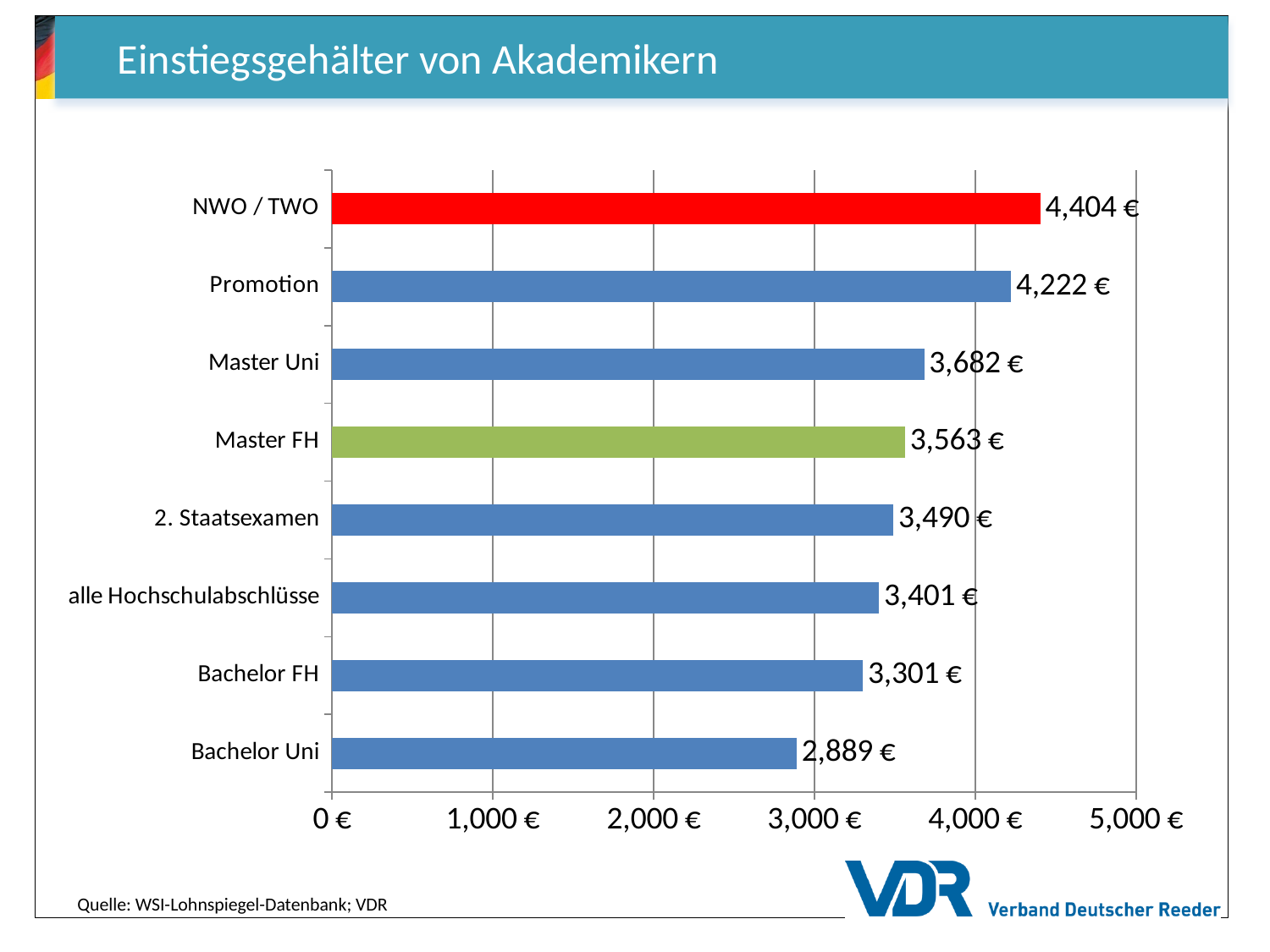
Which category has the highest value? NWO / TWO Which is larger, the value for Master Uni or the value for Master FH? Master Uni Which category has the lowest value? Bachelor Uni What is the value for Master FH? 3,563 € Is the value for Bachelor FH greater or less than 3,000 €? greater What is the difference between the values for Master Uni and Bachelor Uni? 793 € What is the value for Bachelor Uni? 2,889 € What is the difference between the values for NWO / TWO and Promotion? 182 € How many categories are shown in the chart? 8 What is the value for NWO / TWO? 4,404 € What kind of chart is shown on the slide? bar chart What is the value for alle Hochschulabschlüsse? 3,401 €